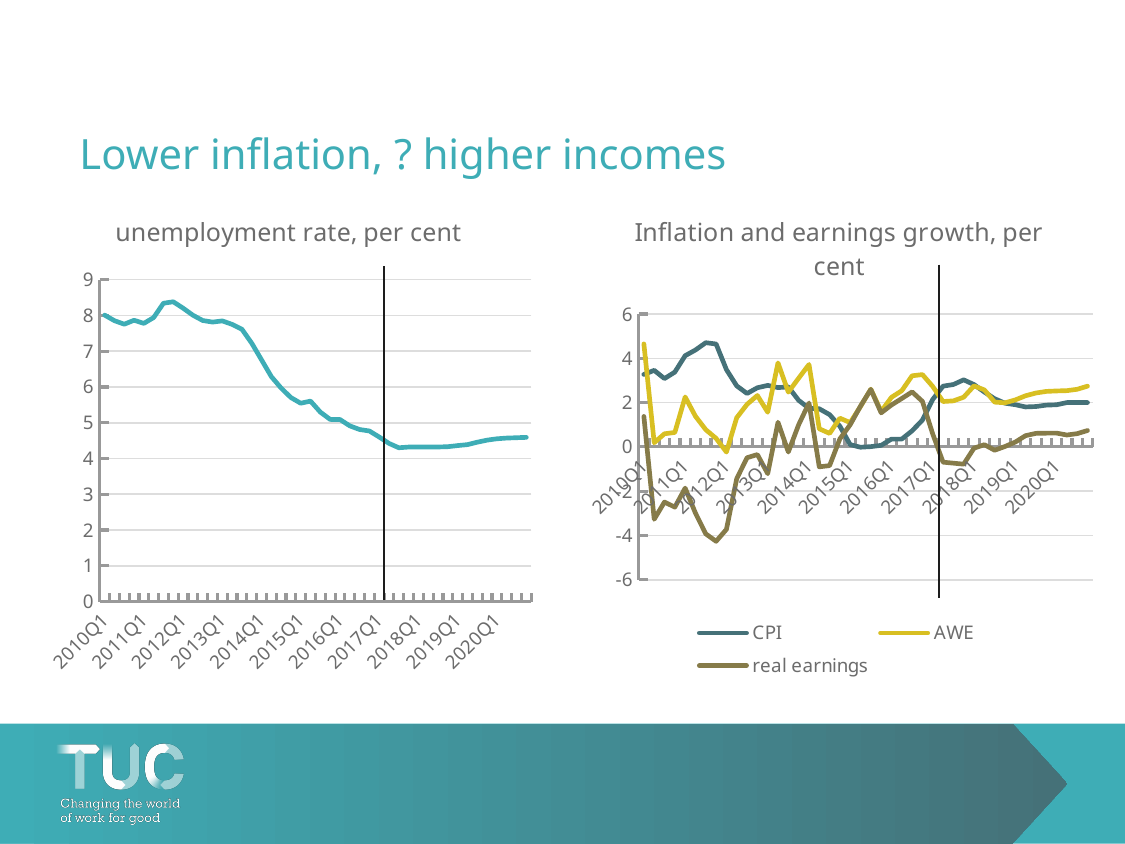
In the 'Inflation and earnings growth, per cent' chart, is the real earnings value at 2012Q1 greater or less than -2? less In the 'Inflation and earnings growth, per cent' chart, which is larger at 2012Q1: CPI or real earnings? CPI In the 'unemployment rate, per cent' chart, is the value at 2010Q1 greater or less than 7? greater In the 'Inflation and earnings growth, per cent' chart, which is larger at 2014Q1: AWE or CPI? AWE What kind of chart is the 'unemployment rate, per cent' chart on the left? line chart How many series does the legend of the 'Inflation and earnings growth, per cent' chart list? 3 In the 'Inflation and earnings growth, per cent' chart, is the CPI value at 2012Q1 greater or less than 4? less What kind of chart is the 'Inflation and earnings growth, per cent' chart on the right? line chart In the 'unemployment rate, per cent' chart, does the unemployment rate rise or fall between 2010Q1 and 2018Q1? fall Which series are listed in the legend of the 'Inflation and earnings growth, per cent' chart? CPI, AWE, real earnings